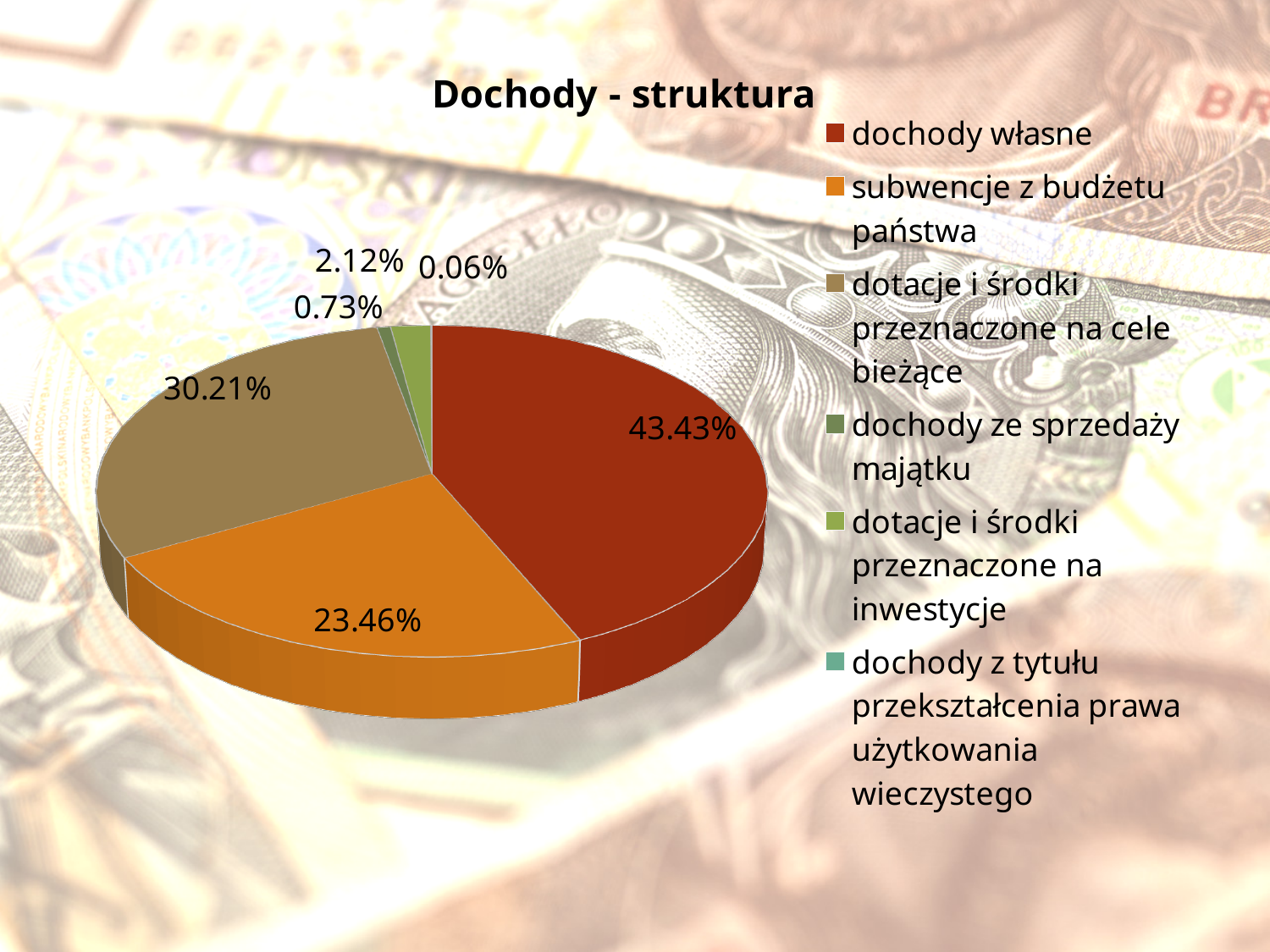
Which category has the largest slice of the pie? dochody własne Which is larger: the share for 'subwencje z budżetu państwa' or for 'dotacje i środki przeznaczone na cele bieżące'? dotacje i środki przeznaczone na cele bieżące What is the title of the chart? Dochody - struktura What share of the pie is labelled for 'dotacje i środki przeznaczone na inwestycje'? 2.12% What colour is the slice for 'dochody własne'? red What share of the pie is labelled for 'dotacje i środki przeznaczone na cele bieżące'? 30.21% What kind of chart is shown on the slide? pie chart What share of the pie is labelled for 'dochody własne'? 43.43% How many entries does the chart's legend list? 6 Which category has the smallest slice of the pie? dochody z tytułu przekształcenia prawa użytkowania wieczystego What is the difference in percentage points between the 'dochody własne' share and the 'subwencje z budżetu państwa' share? 19.97